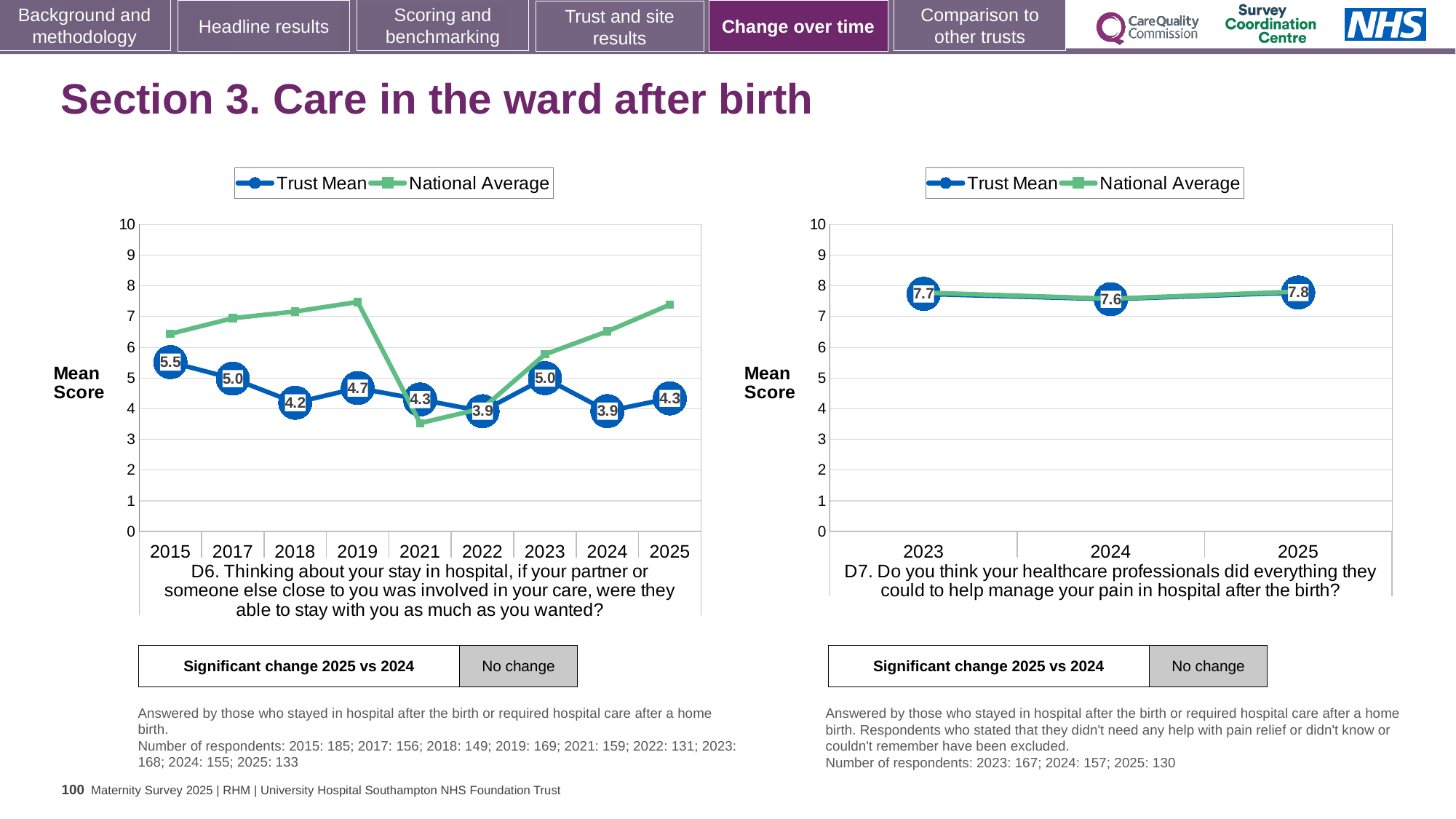
How many series does the legend of the D7 chart on the right list? 2 In the D6 chart on the left, what is the difference between the Trust Mean for 2015 and the Trust Mean for 2025? 1.2 In the D7 chart on the right, which year has the lowest Trust Mean? 2024 In the D6 chart on the left, which year has the highest Trust Mean? 2015 How many years are shown on the x axis of the D6 chart on the left? 9 In the D6 chart on the left, what is the Trust Mean for 2024? 3.9 In the D6 chart on the left, is the Trust Mean higher in 2023 or in 2024? 2023 In the D7 chart on the right, what is the Trust Mean for 2025? 7.8 In the D6 chart on the left, is the National Average for 2019 greater or less than 7? greater In the D6 chart on the left, is the National Average for 2021 greater or less than 4? less What kind of chart is the D7 chart on the right? Line chart In the D6 chart on the left, what is the Trust Mean for 2015? 5.5